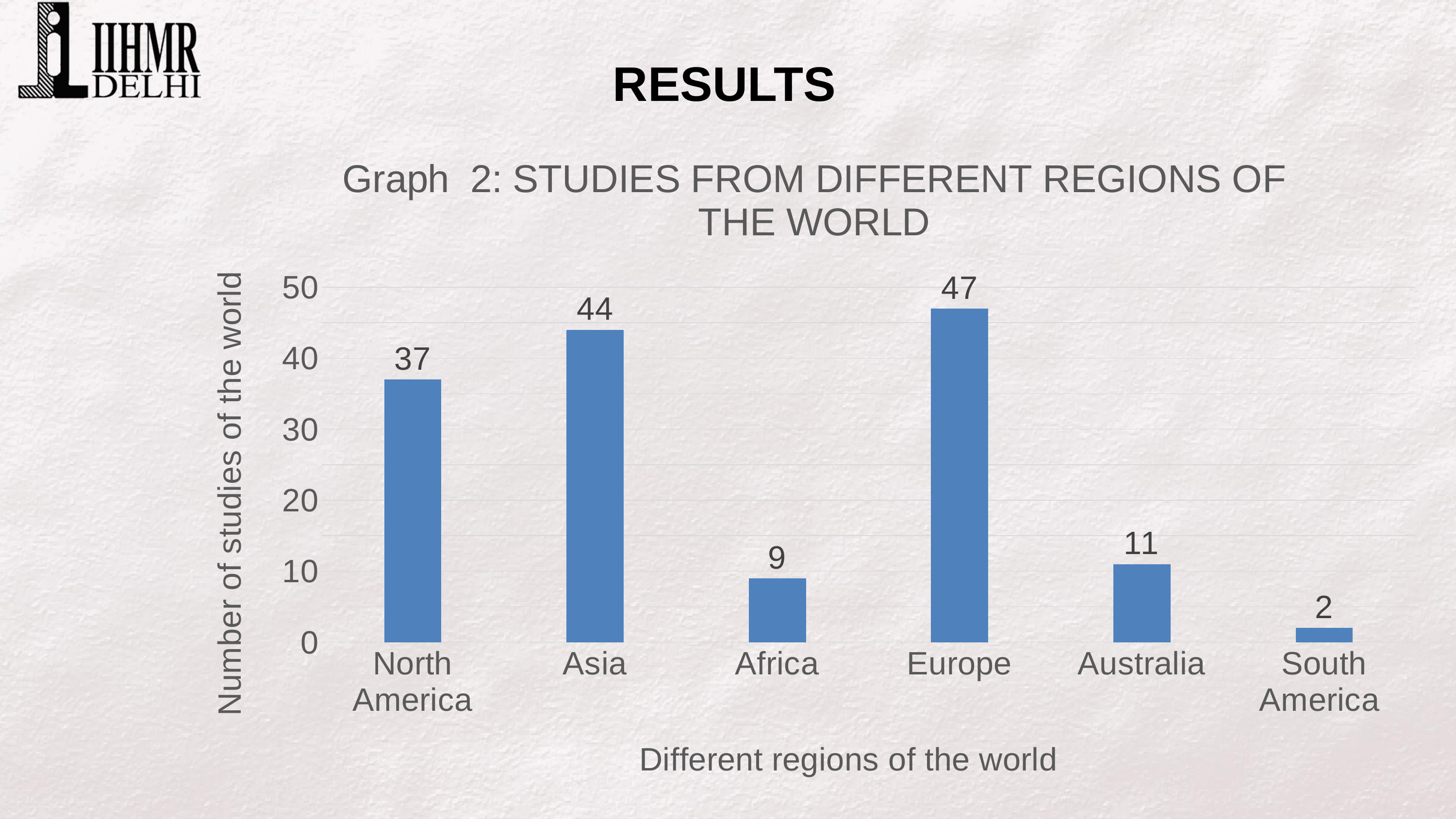
Which region has the lowest number of studies? South America How many studies are from North America? 37 What type of chart is shown on the slide? Bar chart Which region has the highest number of studies? Europe How many studies are from Africa? 9 How many studies are from Australia? 11 What is the difference between the number of studies from Europe and from Asia? 3 How many regions are shown on the x axis of the chart? 6 How many studies are from Asia? 44 What is the difference between the number of studies from North America and from Africa? 28 Which has more studies, Australia or Africa? Australia What is the label of the vertical axis of the chart? Number of studies of the world